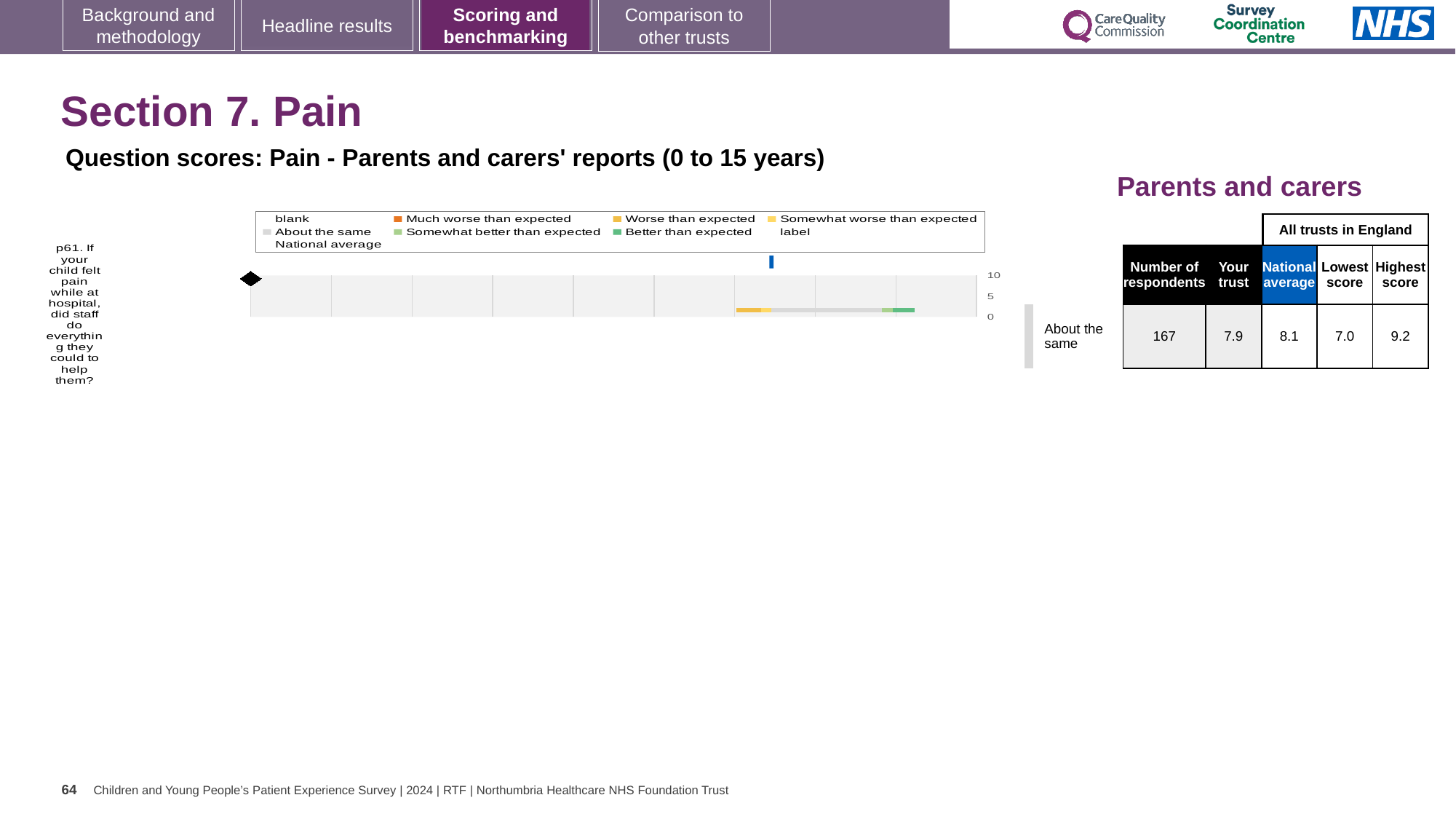
What kind of chart is shown on the slide for question p61? bar chart What is the highest tick value shown on the chart's axis? 10 How many survey questions are plotted in the chart? 1 How many entries does the chart legend list? 9 What is the difference between the highest score (9.2) and the lowest score (7.0) for question p61? 2.2 Which is larger for question p61: the 'Your trust' score or the national average? National average In the table next to the chart, what is the 'Your trust' score for question p61? 7.9 Is the national average marker for question p61 greater or less than 5 on the chart axis? greater In the table next to the chart, what is the national average score for question p61? 8.1 In the table next to the chart, what is the lowest score among all trusts in England for question p61? 7.0 In the table next to the chart, what is the number of respondents for question p61? 167